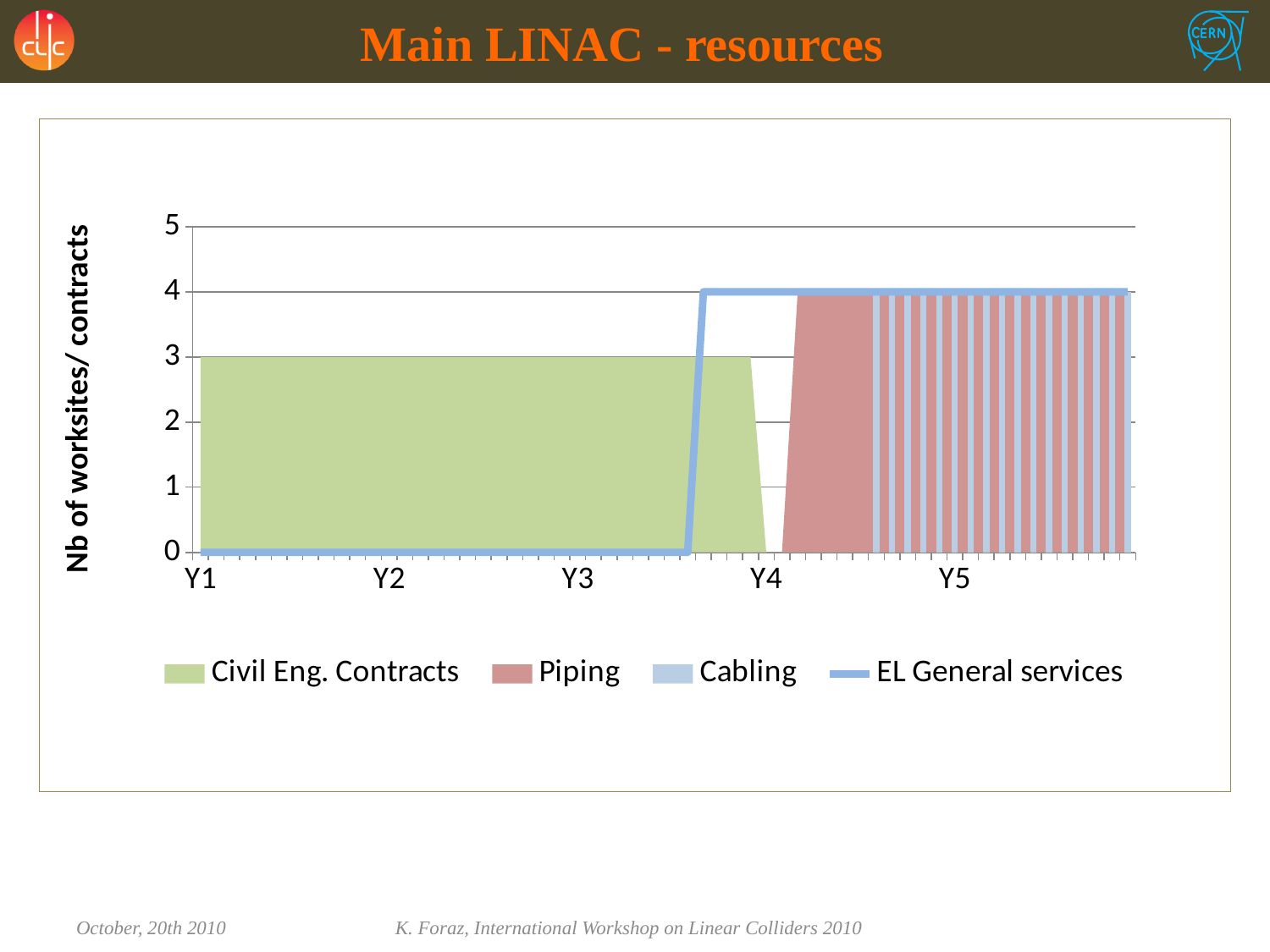
Is the value for Civil Eng. Contracts at Y3 greater or less than 4? less What is the value of Piping at Y5? 4 What are the labels on the horizontal axis? Y1, Y2, Y3, Y4, Y5 What is the value of EL General services at Y2? 0 What is the value of Civil Eng. Contracts at Y2? 3 What is the difference between the Piping value at Y5 and the Civil Eng. Contracts value at Y2? 1 What is the value of EL General services at Y5? 4 What is the highest value shown on the vertical axis? 5 How many series does the legend list? 4 Which is larger at Y5, Piping or Civil Eng. Contracts? Piping What is the label of the vertical axis? Nb of worksites/ contracts Does the EL General services line rise or fall between Y3 and Y5? rise